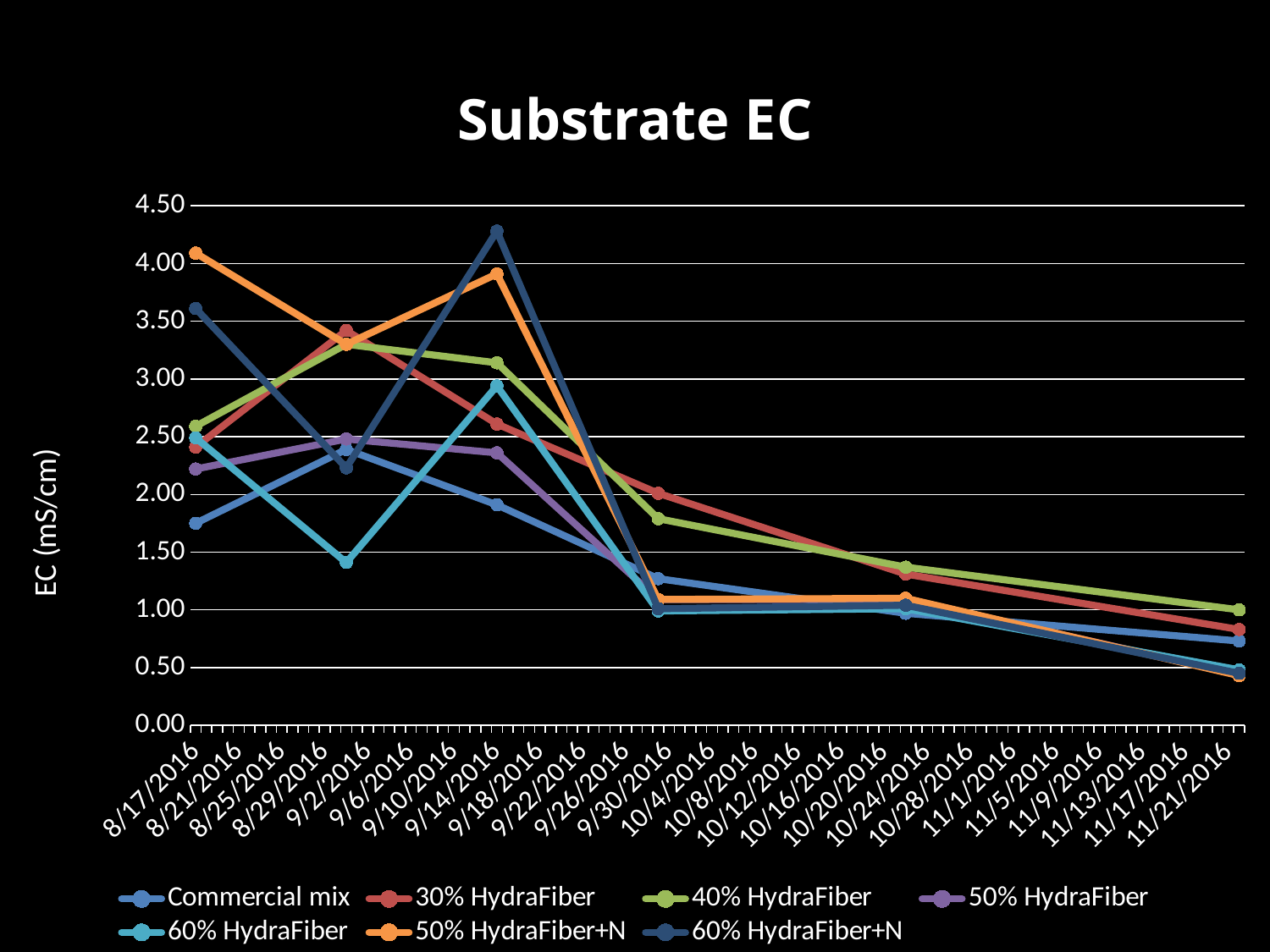
What kind of chart is shown on the slide? line chart Is the value for 50% HydraFiber+N on 8/17/2016 greater or less than 4.00? greater Is the value for Commercial mix on 8/17/2016 greater or less than 2.00? less Does the value for 40% HydraFiber rise or fall from 9/14/2016 to 11/21/2016? fall Which is larger on 11/21/2016, the value for 40% HydraFiber or the value for 30% HydraFiber? 40% HydraFiber What is the label on the y axis? EC (mS/cm) What is the title of the chart? Substrate EC Which series has the highest value on 9/14/2016? 60% HydraFiber+N Which series has the highest value on 8/17/2016? 50% HydraFiber+N Which series has the lowest value on 8/17/2016? Commercial mix How many series does the legend list? 7